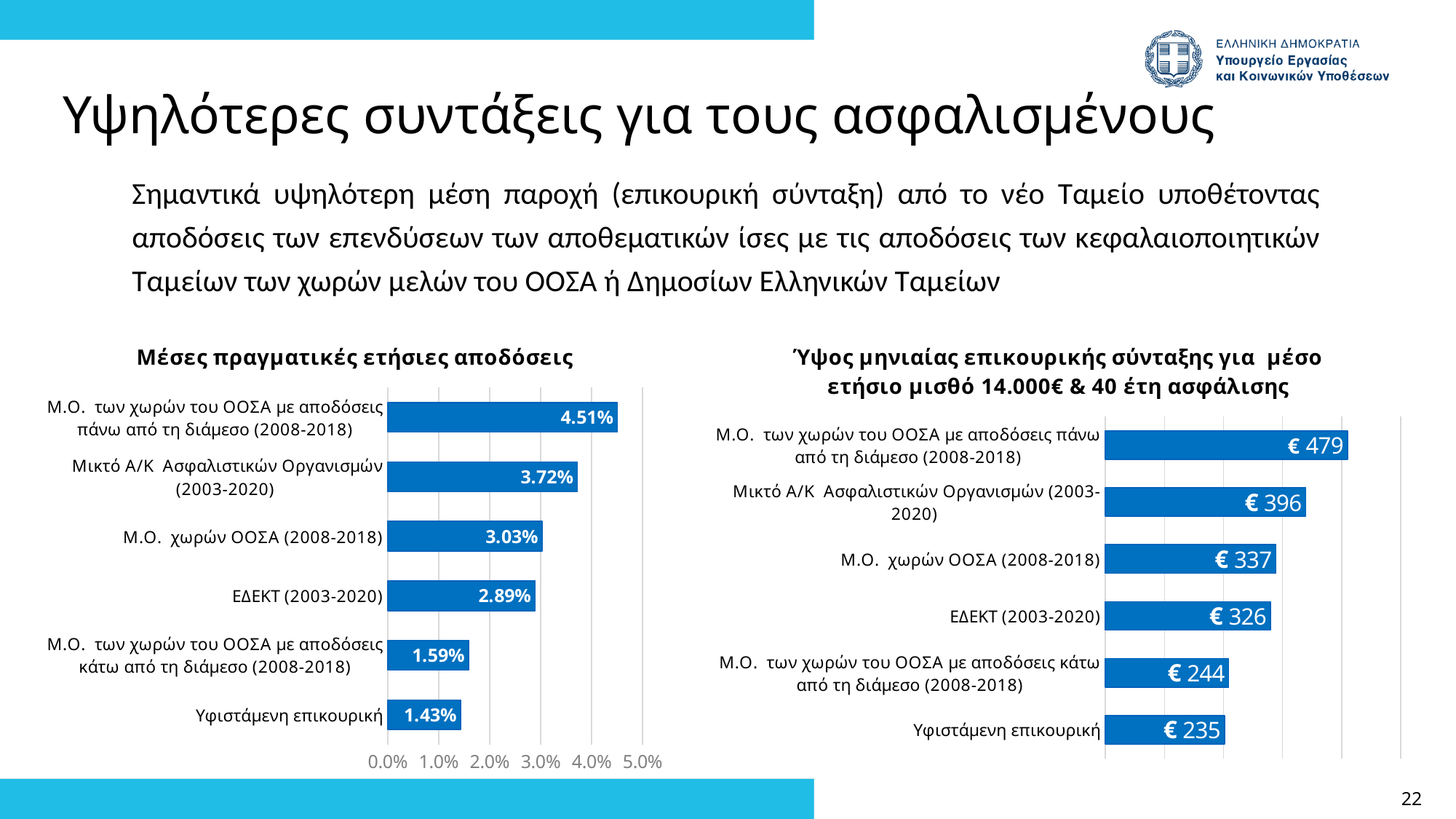
In the left chart (Μέσες πραγματικές ετήσιες αποδόσεις), what is the highest value shown on the x axis? 5.0% In the right chart (Ύψος μηνιαίας επικουρικής σύνταξης), what is the difference between the highest value and the value for Υφιστάμενη επικουρική? € 244 In the left chart (Μέσες πραγματικές ετήσιες αποδόσεις), how many categories are shown? 6 In the right chart (Ύψος μηνιαίας επικουρικής σύνταξης), what is the value for Μ.Ο. χωρών ΟΟΣΑ (2008-2018)? € 337 In the right chart (Ύψος μηνιαίας επικουρικής σύνταξης), which is larger: Μικτό Α/Κ Ασφαλιστικών Οργανισμών (2003-2020) or ΕΔΕΚΤ (2003-2020)? Μικτό Α/Κ Ασφαλιστικών Οργανισμών (2003-2020) In the left chart (Μέσες πραγματικές ετήσιες αποδόσεις), what is the difference between Μικτό Α/Κ Ασφαλιστικών Οργανισμών (2003-2020) and Μ.Ο. χωρών ΟΟΣΑ (2008-2018)? 0.69% What type of chart is the right chart (Ύψος μηνιαίας επικουρικής σύνταξης)? Bar chart In the left chart (Μέσες πραγματικές ετήσιες αποδόσεις), what is the value for ΕΔΕΚΤ (2003-2020)? 2.89% In the right chart (Ύψος μηνιαίας επικουρικής σύνταξης), what is the value for Μ.Ο. των χωρών του ΟΟΣΑ με αποδόσεις κάτω από τη διάμεσο (2008-2018)? € 244 In the left chart (Μέσες πραγματικές ετήσιες αποδόσεις), what is the value for Υφιστάμενη επικουρική? 1.43% In the left chart (Μέσες πραγματικές ετήσιες αποδόσεις), which category has the highest value? Μ.Ο. των χωρών του ΟΟΣΑ με αποδόσεις πάνω από τη διάμεσο (2008-2018) In the right chart (Ύψος μηνιαίας επικουρικής σύνταξης), which category has the lowest value? Υφιστάμενη επικουρική